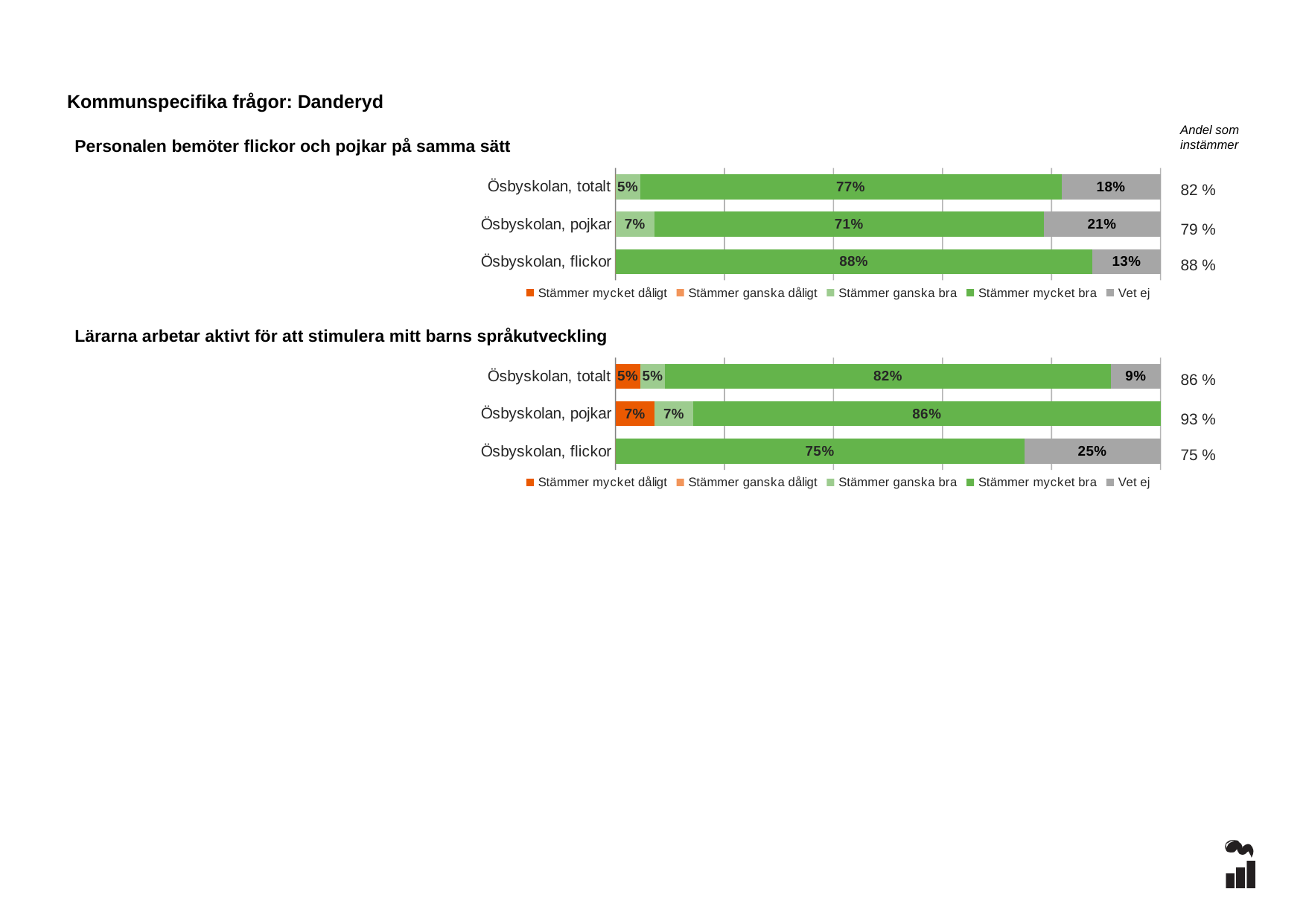
In the chart 'Lärarna arbetar aktivt för att stimulera mitt barns språkutveckling', is the 'Stämmer mycket bra' value larger for Ösbyskolan, totalt or Ösbyskolan, pojkar? Ösbyskolan, pojkar What kind of chart is 'Personalen bemöter flickor och pojkar på samma sätt'? Stacked bar chart In the chart 'Personalen bemöter flickor och pojkar på samma sätt', what is the difference between the 'Stämmer mycket bra' values for Ösbyskolan, flickor and Ösbyskolan, pojkar? 17% In the chart 'Lärarna arbetar aktivt för att stimulera mitt barns språkutveckling', what is the difference between the 'Vet ej' values for Ösbyskolan, flickor and Ösbyskolan, totalt? 16% In the chart 'Personalen bemöter flickor och pojkar på samma sätt', what is the 'Stämmer mycket bra' value for Ösbyskolan, totalt? 77% In the chart 'Lärarna arbetar aktivt för att stimulera mitt barns språkutveckling', what is the 'Stämmer mycket dåligt' value for Ösbyskolan, pojkar? 7% In the chart 'Personalen bemöter flickor och pojkar på samma sätt', what is the 'Vet ej' value for Ösbyskolan, pojkar? 21% In the chart 'Personalen bemöter flickor och pojkar på samma sätt', which category has the highest 'Stämmer mycket bra' value? Ösbyskolan, flickor In the chart 'Lärarna arbetar aktivt för att stimulera mitt barns språkutveckling', what is the 'Vet ej' value for Ösbyskolan, flickor? 25% In the chart 'Lärarna arbetar aktivt för att stimulera mitt barns språkutveckling', which category has the lowest 'Stämmer mycket bra' value? Ösbyskolan, flickor How many series does the legend of the chart 'Lärarna arbetar aktivt för att stimulera mitt barns språkutveckling' list? 5 How many categories are shown in the chart 'Personalen bemöter flickor och pojkar på samma sätt'? 3